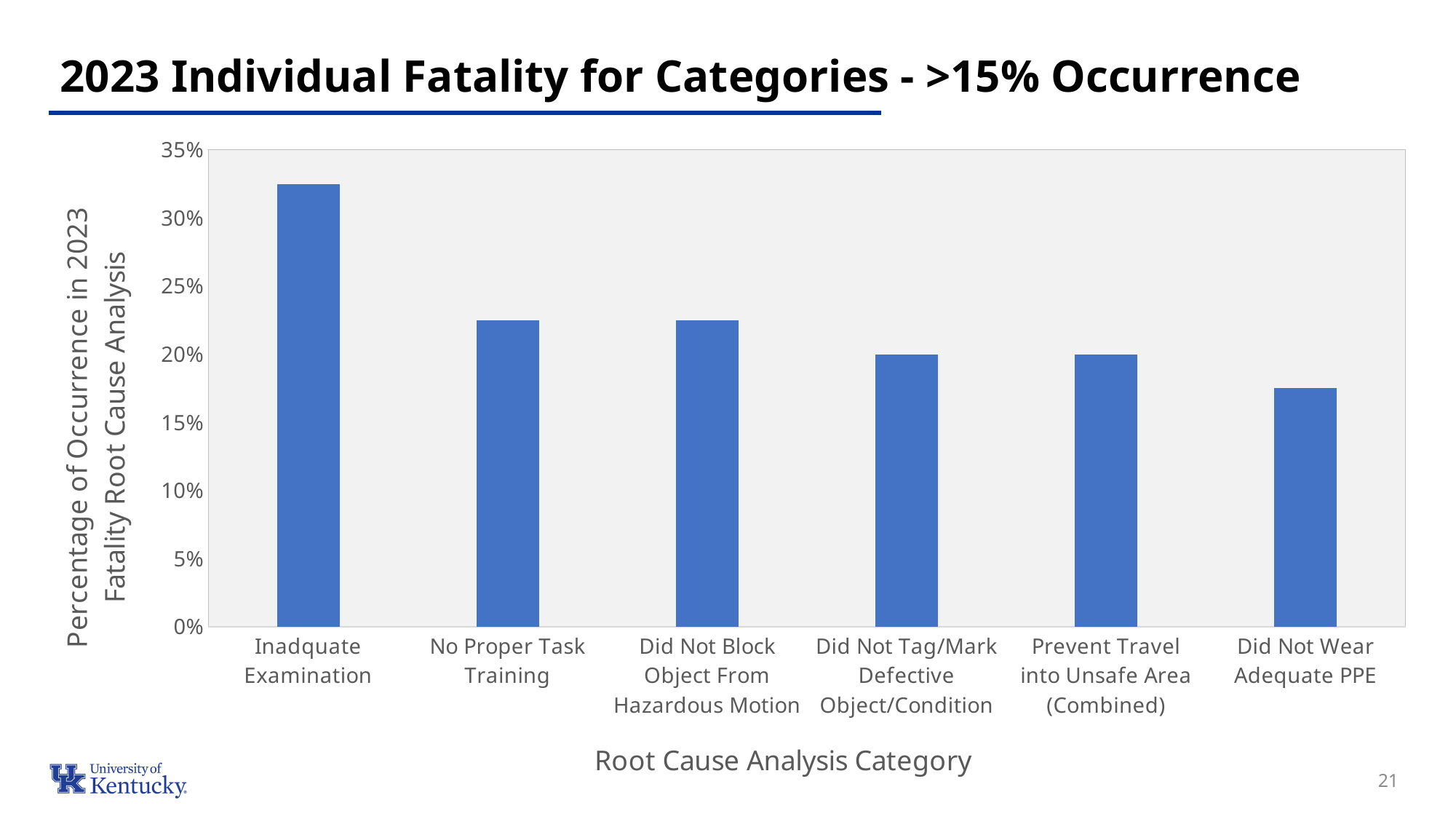
Is the value for Did Not Block Object From Hazardous Motion greater or less than 25%? less Which category has the highest percentage of occurrence? Inadquate Examination Is the value for Inadquate Examination greater or less than 30%? greater What kind of chart is shown on the slide? Bar chart Is the value for Did Not Wear Adequate PPE greater or less than 20%? less Which is larger, the value for Inadquate Examination or the value for No Proper Task Training? Inadquate Examination What is the title of the y axis? Percentage of Occurrence in 2023 Fatality Root Cause Analysis Which category has the lowest percentage of occurrence? Did Not Wear Adequate PPE How many root cause analysis categories are plotted in the chart? 6 Do the values generally rise or fall moving from left to right along the x axis? Fall What is the title of the x axis? Root Cause Analysis Category